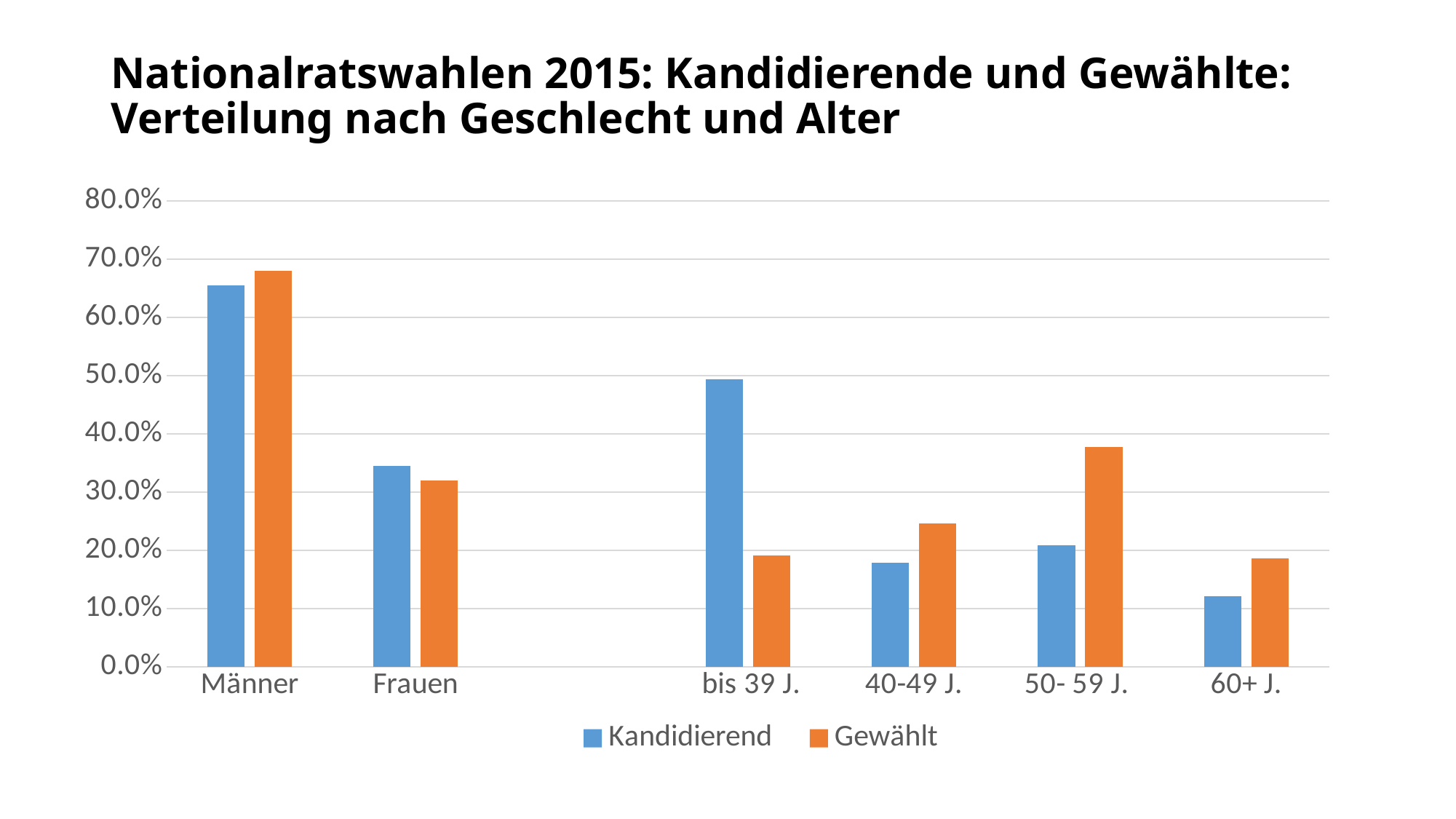
Which category has the highest Gewählt value? Männer Is the Kandidierend value for Männer greater or less than 60.0%? greater Which category has the lowest Kandidierend value? 60+ J. How many series does the legend list? 2 Is the Gewählt value for 50- 59 J. greater or less than 30.0%? greater For 50- 59 J., which is larger: Kandidierend or Gewählt? Gewählt Is the Kandidierend value for 60+ J. greater or less than 20.0%? less What kind of chart is shown on the slide? bar chart Which colour represents the Gewählt series? orange For bis 39 J., which is larger: Kandidierend or Gewählt? Kandidierend How many categories are shown on the x axis? 6 Which category has the highest Kandidierend value? Männer